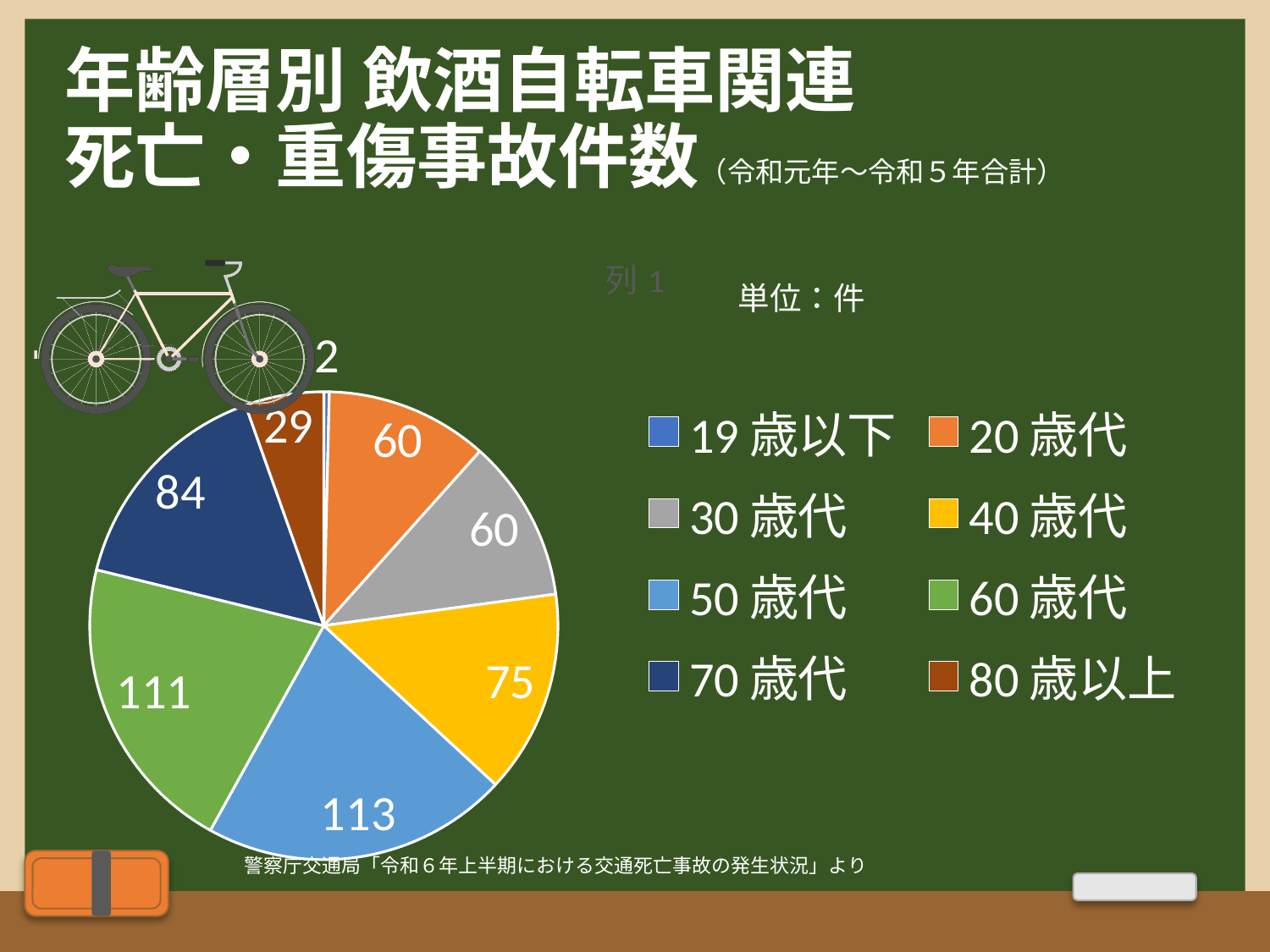
What unit is stated for the values in the chart? 件 How many categories does the pie chart have? 8 What is the value for 80歳以上? 29 Which is larger, the value for 40歳代 or the value for 80歳以上? 40歳代 Which age group has the highest value? 50歳代 What kind of chart is shown on the slide? pie chart How many entries does the legend list? 8 What is the difference between the values for 60歳代 and 70歳代? 27 Which age group has the lowest value? 19歳以下 What is the value for 50歳代? 113 What is the value for 70歳代? 84 What is the value for 40歳代? 75